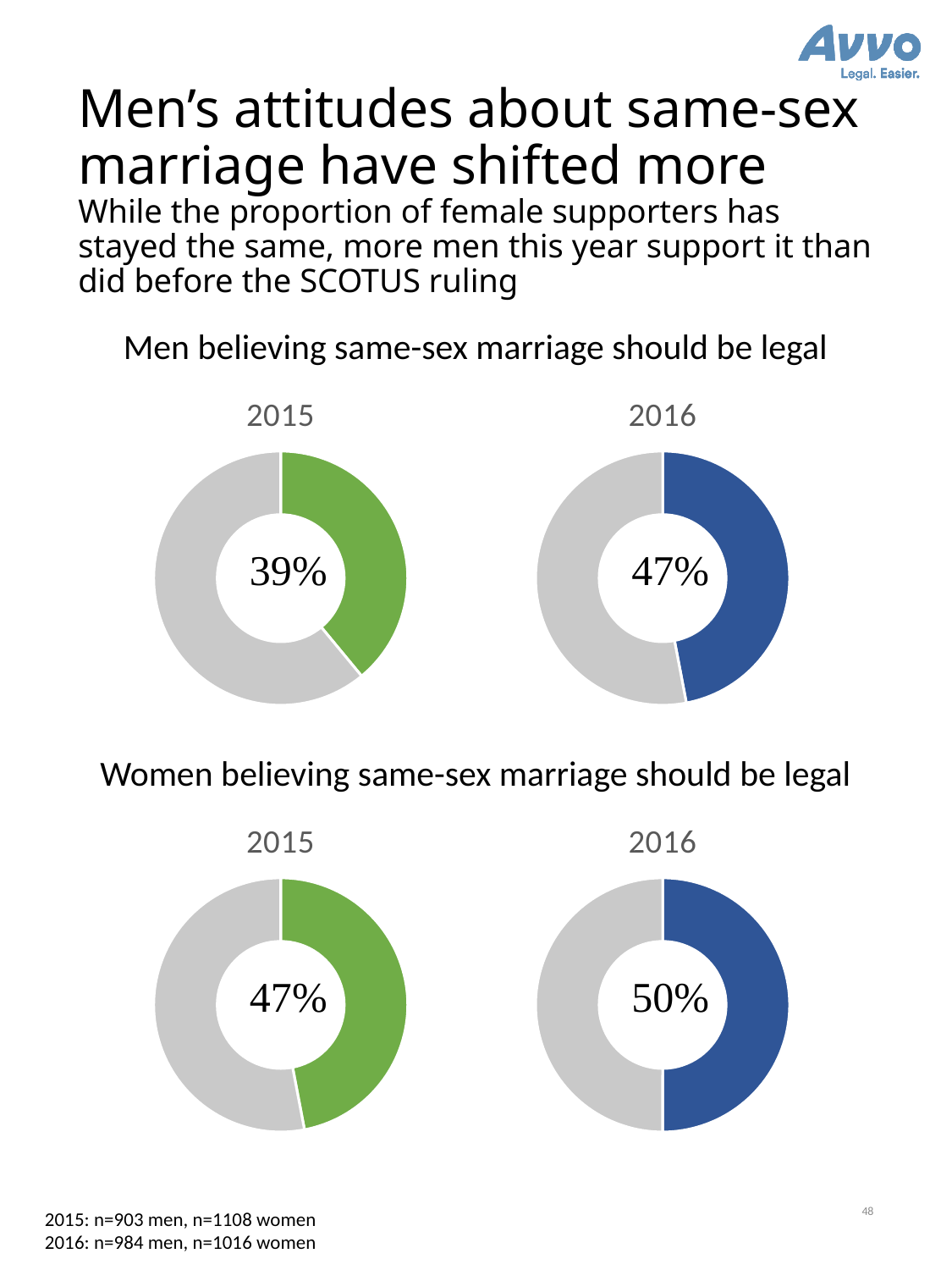
Which is larger: the 2016 value for men or the 2016 value for women? Women (50%) In the 'Women believing same-sex marriage should be legal' chart, what percentage is shown for 2015? 47% In the 'Men believing same-sex marriage should be legal' chart, does the value rise or fall from 2015 to 2016? Rise In the 'Men believing same-sex marriage should be legal' chart, what percentage is shown for 2016? 47% In the 'Women believing same-sex marriage should be legal' chart, what percentage is shown for 2016? 50% What colour is the highlighted segment in the 2016 donut charts? Blue In the 'Men believing same-sex marriage should be legal' chart, by how many percentage points did the value increase from 2015 to 2016? 8 percentage points In the 'Men believing same-sex marriage should be legal' chart, what percentage is shown for 2015? 39% In the 'Women believing same-sex marriage should be legal' chart, by how many percentage points did the value increase from 2015 to 2016? 3 percentage points How many donut charts are shown on the slide? 4 In the 'Men believing same-sex marriage should be legal' chart, which year has the higher value, 2015 or 2016? 2016 What kind of chart is used to show the percentages on this slide? Donut (pie) chart